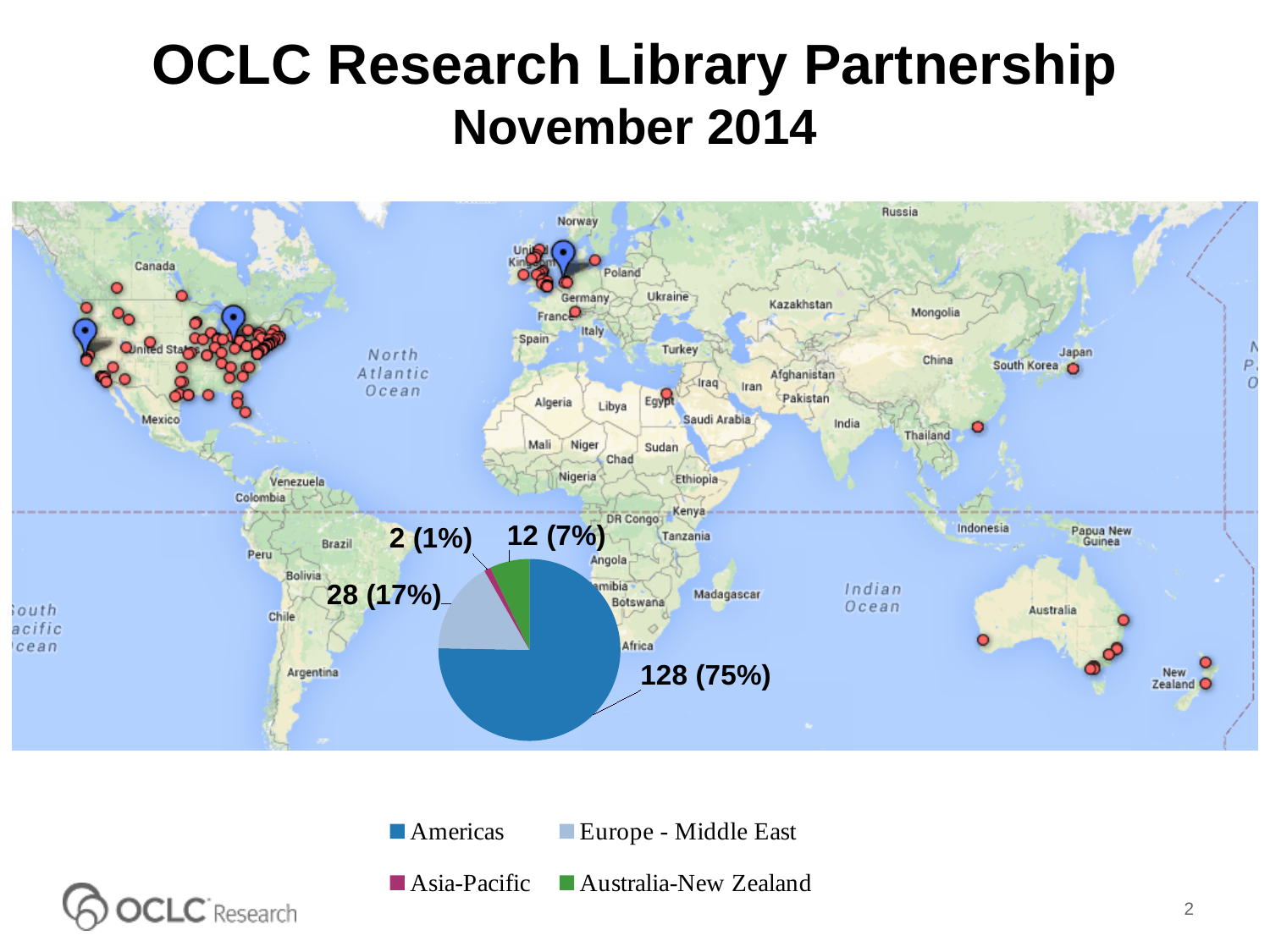
What kind of chart is shown on the slide? pie chart What is the value shown for Australia-New Zealand in the pie chart? 12 (7%) Which region has the largest slice of the pie chart? Americas Which region has the smallest slice of the pie chart? Asia-Pacific What is the value shown for Europe - Middle East in the pie chart? 28 (17%) How many slices does the pie chart have? 4 What share of the pie does Europe - Middle East represent? 17% How many entries does the legend of the pie chart list? 4 What is the value shown for Asia-Pacific in the pie chart? 2 (1%) What is the difference between the Americas count and the Europe - Middle East count in the pie chart? 100 What is the value shown for Americas in the pie chart? 128 (75%) Which is larger in the pie chart, Australia-New Zealand or Asia-Pacific? Australia-New Zealand